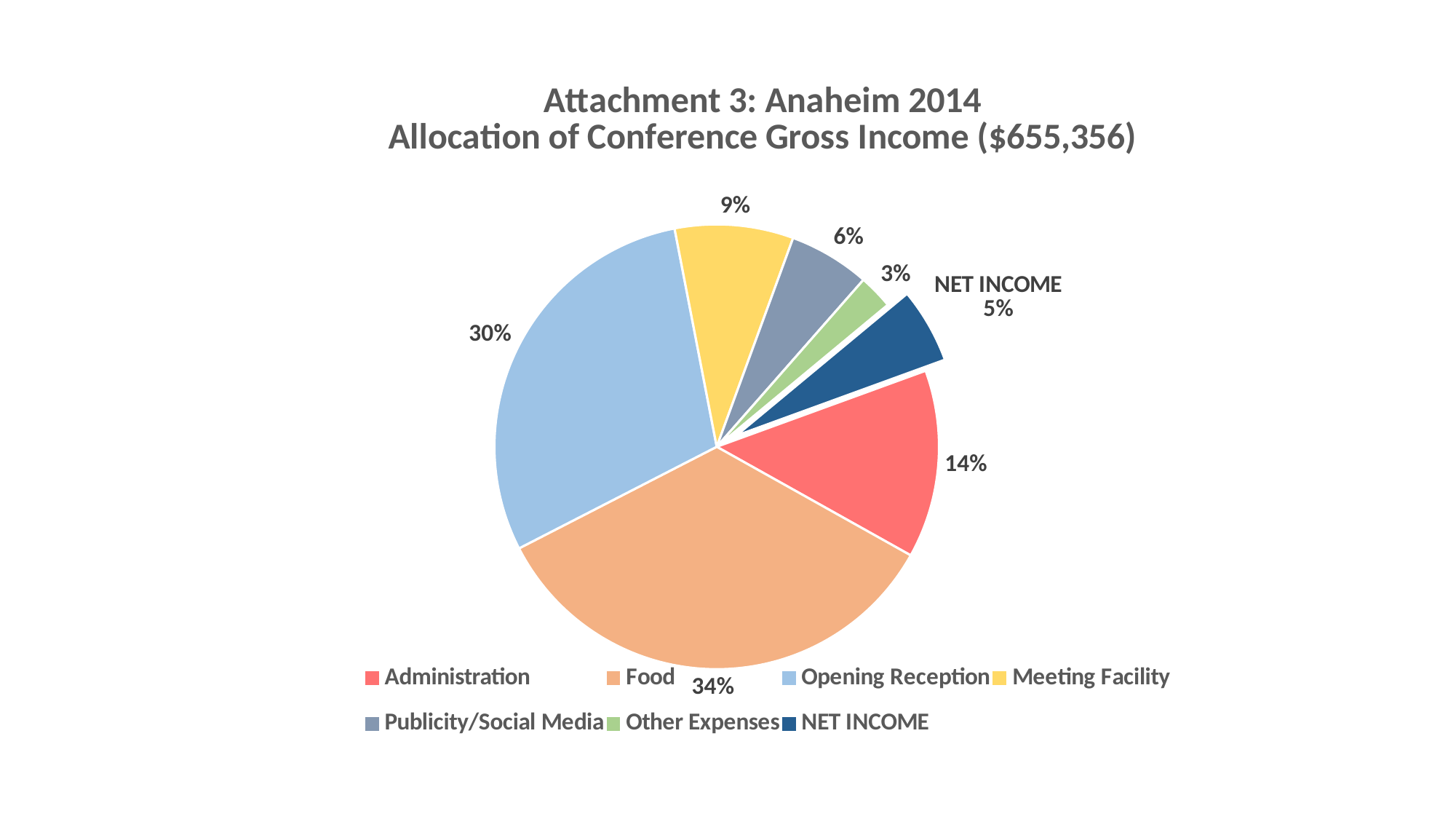
Which category has the smallest slice of the pie? Other Expenses What share of the conference gross income is allocated to Food? 34% What is the value shown for Administration? 14% How many categories does the legend list? 7 What kind of chart is shown on the slide? Pie chart Which is larger, Administration or Meeting Facility? Administration Which category has the largest slice of the pie? Food What percentage of the pie does Opening Reception represent? 30% What total gross income amount is stated in the chart title? $655,356 What is the difference in percentage points between Food and Opening Reception? 4 What share is shown for NET INCOME? 5% What percentage is labelled for Meeting Facility? 9%